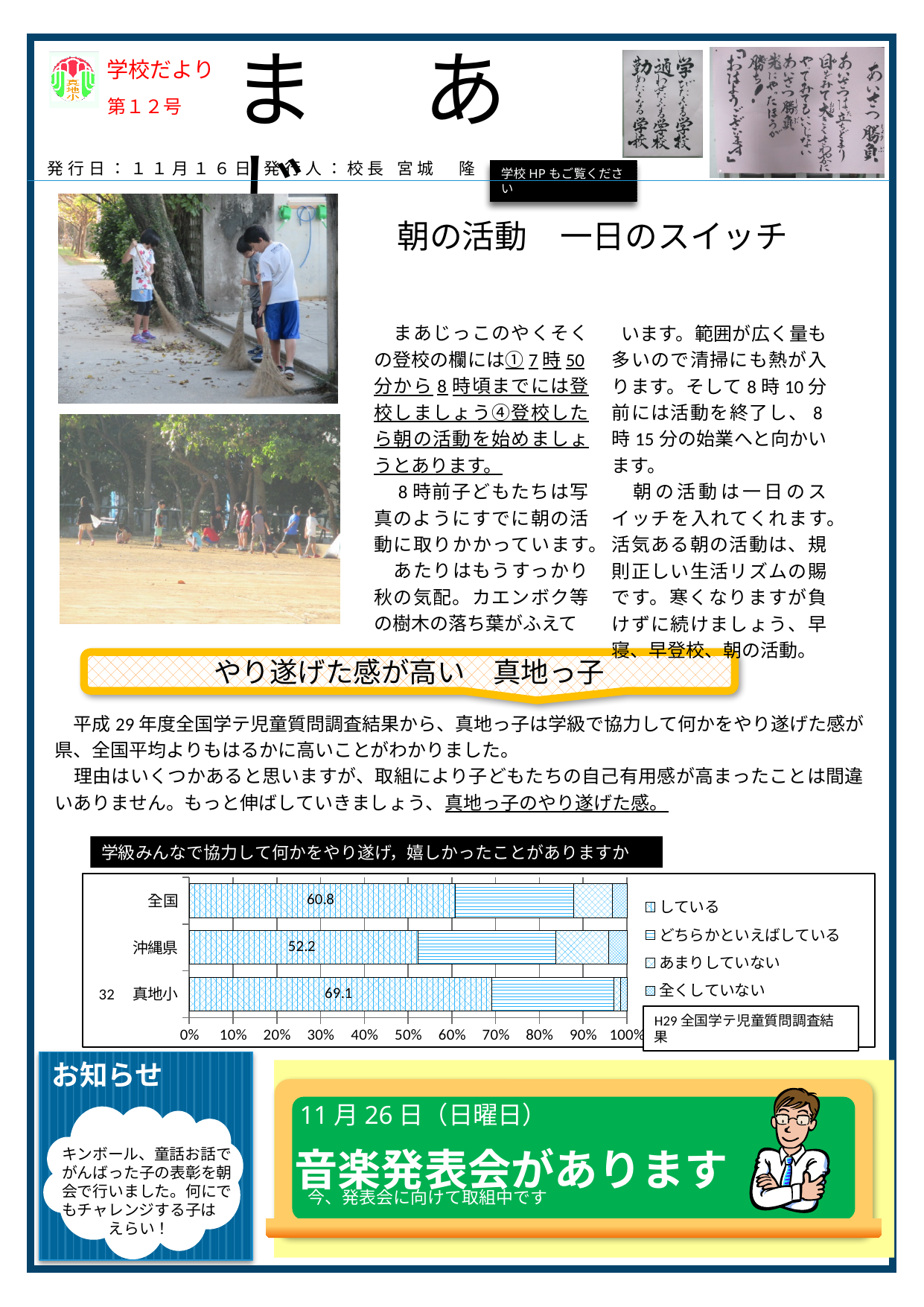
What is the value for している for 真地小? 69.1 What is the value for している for 沖縄県? 52.2 Which has a larger している value, 真地小 or 沖縄県? 真地小 How many categories are shown on the chart? 3 How many series does the chart legend list? 4 Which category has the highest value for している? 真地小 What kind of chart is shown on the slide? stacked bar chart Is the している value for 真地小 greater or less than 60%? greater What is the difference between the している values for 真地小 and 全国? 8.3 What is the difference between the している values for 全国 and 沖縄県? 8.6 Which category has the lowest value for している? 沖縄県 What is the value for している for 全国? 60.8